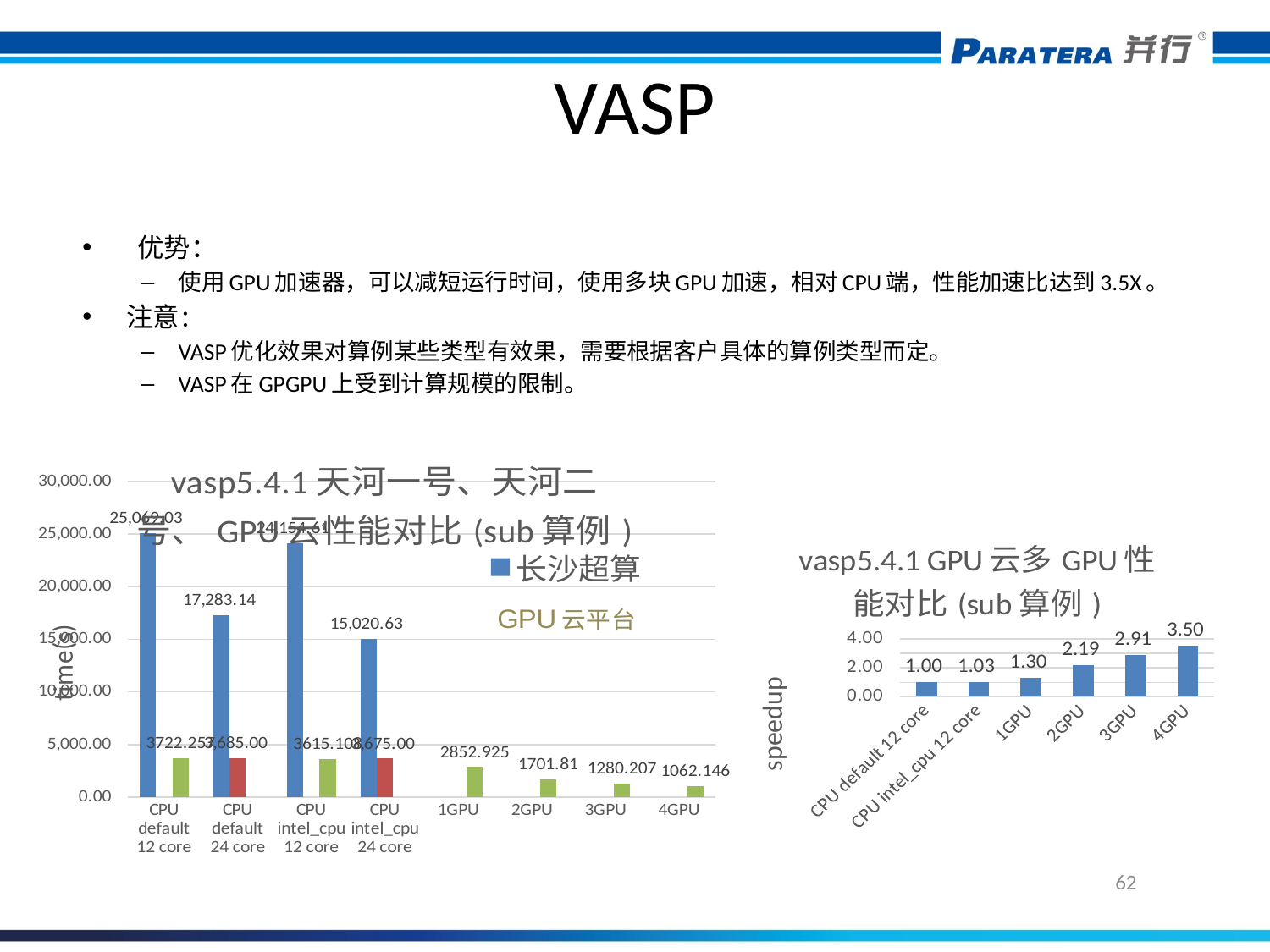
In the left chart (vasp5.4.1 天河一号、天河二号、GPU云性能对比), what is the 长沙超算 time for CPU default 12 core? 25,069.03 In the left chart (vasp5.4.1 天河一号、天河二号、GPU云性能对比), what is the 长沙超算 time for CPU default 24 core? 17,283.14 In the right chart (vasp5.4.1 GPU云多GPU性能对比), how many categories are plotted? 6 In the right chart (vasp5.4.1 GPU云多GPU性能对比), what is the speedup for 2GPU? 2.19 In the left chart (vasp5.4.1 天河一号、天河二号、GPU云性能对比), which is larger, the time for 1GPU or the time for 4GPU? 1GPU In the right chart (vasp5.4.1 GPU云多GPU性能对比), do the speedup values rise or fall from left to right along the x axis? rise In the right chart (vasp5.4.1 GPU云多GPU性能对比), what is the difference between the speedup for 4GPU and the speedup for 1GPU? 2.20 In the left chart (vasp5.4.1 天河一号、天河二号、GPU云性能对比), what is the difference between the 长沙超算 times for CPU default 12 core and CPU default 24 core? 7,785.89 In the right chart (vasp5.4.1 GPU云多GPU性能对比), which category has the highest speedup? 4GPU In the right chart (vasp5.4.1 GPU云多GPU性能对比), what is the speedup for 4GPU? 3.50 What kind of chart is the left chart (vasp5.4.1 天河一号、天河二号、GPU云性能对比)? bar chart In the left chart (vasp5.4.1 天河一号、天河二号、GPU云性能对比), what is the time for 4GPU? 1062.146